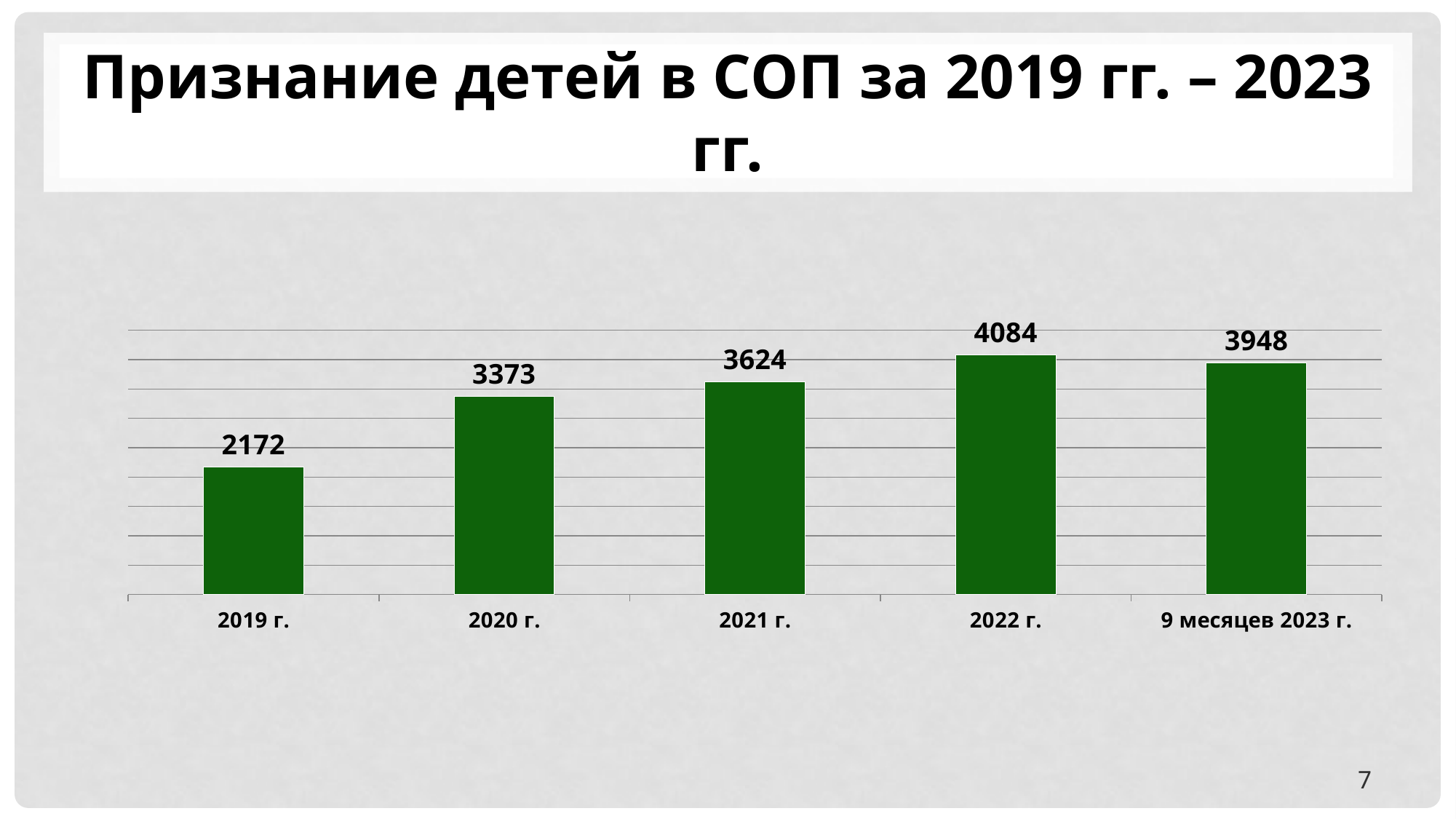
What is the value for 2019 г.? 2172 What is the difference between the values for 2020 г. and 2019 г.? 1201 Which category has the highest value? 2022 г. What is the value for 9 месяцев 2023 г.? 3948 Do the values rise or fall from 2019 г. to 2022 г.? rise What is the value for 2021 г.? 3624 What is the difference between the values for 2022 г. and 2019 г.? 1912 How many categories are shown on the x axis? 5 Which category has the lowest value? 2019 г. What kind of chart is shown on the slide? bar chart Which is larger, the value for 2021 г. or the value for 9 месяцев 2023 г.? 9 месяцев 2023 г. What is the title of the slide? Признание детей в СОП за 2019 гг. – 2023 гг.